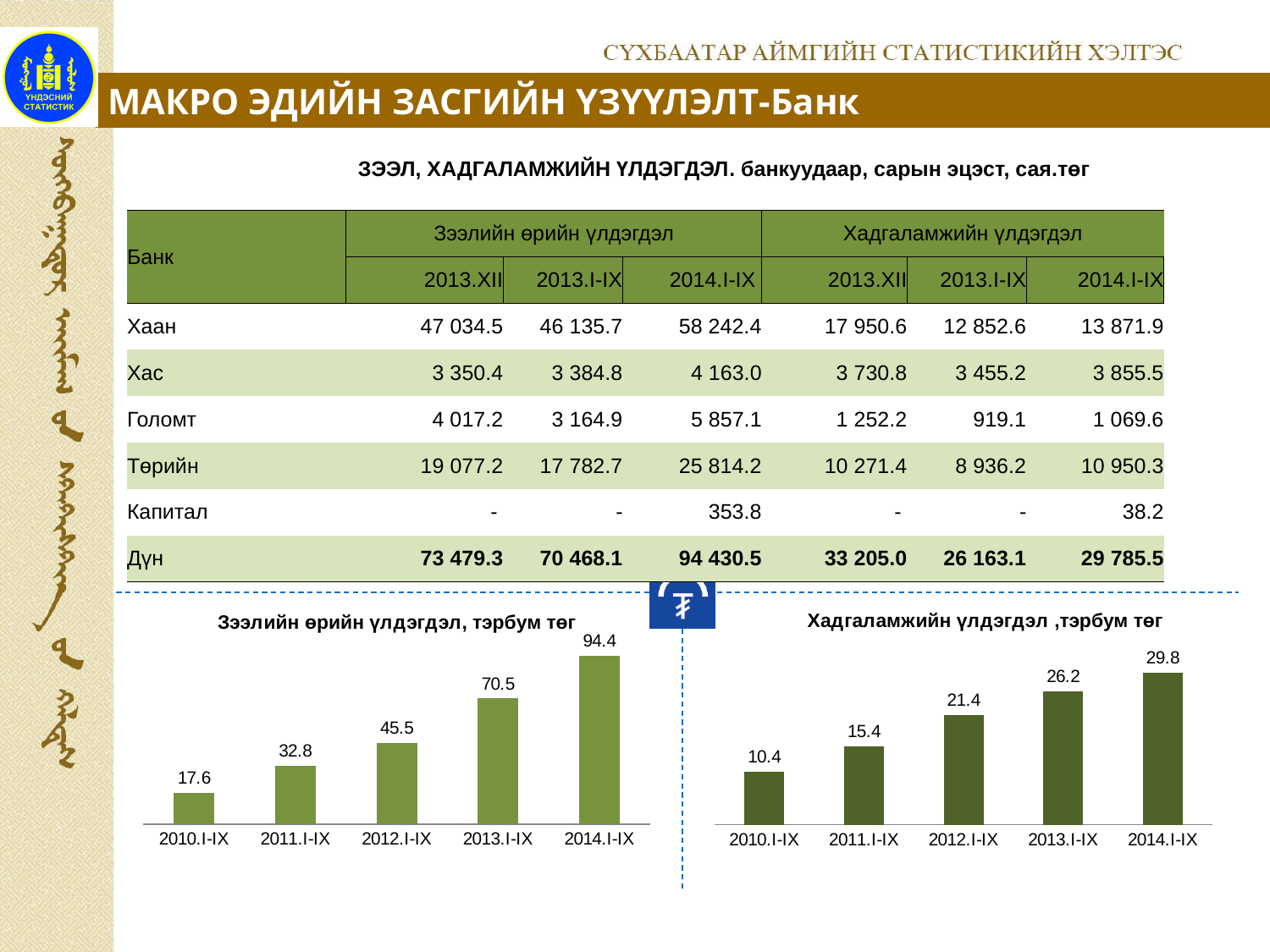
In the left chart (Зээлийн өрийн үлдэгдэл, тэрбум төг), what is the difference between the values for 2014.I-IX and 2013.I-IX? 23.9 In the right chart (Хадгаламжийн үлдэгдэл, тэрбум төг), which period has the lowest value? 2010.I-IX In the right chart (Хадгаламжийн үлдэгдэл, тэрбум төг), what is the value for 2014.I-IX? 29.8 In the right chart (Хадгаламжийн үлдэгдэл, тэрбум төг), do the values rise or fall from 2010.I-IX to 2014.I-IX? Rise How many bars are shown in the right chart (Хадгаламжийн үлдэгдэл, тэрбум төг)? 5 In the left chart (Зээлийн өрийн үлдэгдэл, тэрбум төг), what is the value for 2014.I-IX? 94.4 What type of chart is the left chart (Зээлийн өрийн үлдэгдэл, тэрбум төг)? Bar chart In the right chart (Хадгаламжийн үлдэгдэл, тэрбум төг), what is the value for 2012.I-IX? 21.4 In the left chart (Зээлийн өрийн үлдэгдэл, тэрбум төг), which period has the highest value? 2014.I-IX In the left chart (Зээлийн өрийн үлдэгдэл, тэрбум төг), which is larger: the value for 2012.I-IX or 2011.I-IX? 2012.I-IX In the left chart (Зээлийн өрийн үлдэгдэл, тэрбум төг), what is the value for 2010.I-IX? 17.6 In the right chart (Хадгаламжийн үлдэгдэл, тэрбум төг), what is the difference between the values for 2013.I-IX and 2012.I-IX? 4.8